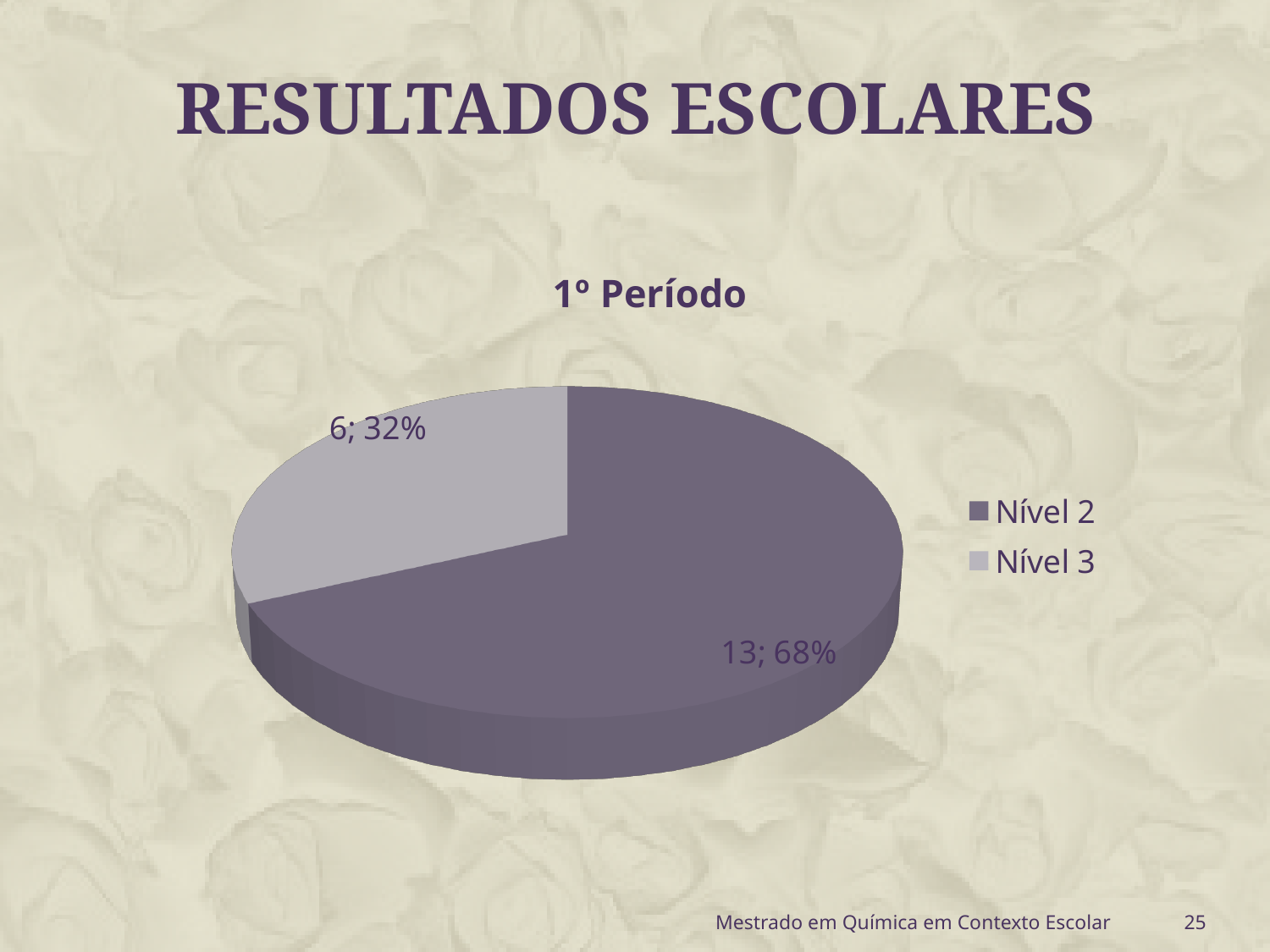
How many entries does the legend list? 2 Which category has the smallest slice? Nível 3 What kind of chart is shown on the slide? Pie chart What is the difference between the counts for Nível 2 and Nível 3? 7 What share of the pie does Nível 3 represent? 32% What is the total count across both slices? 19 What is the count for Nível 3? 6 What is the count for Nível 2? 13 How many slices does the pie chart have? 2 What is the title of the chart? 1º Período What share of the pie does Nível 2 represent? 68% Which category has the largest slice? Nível 2